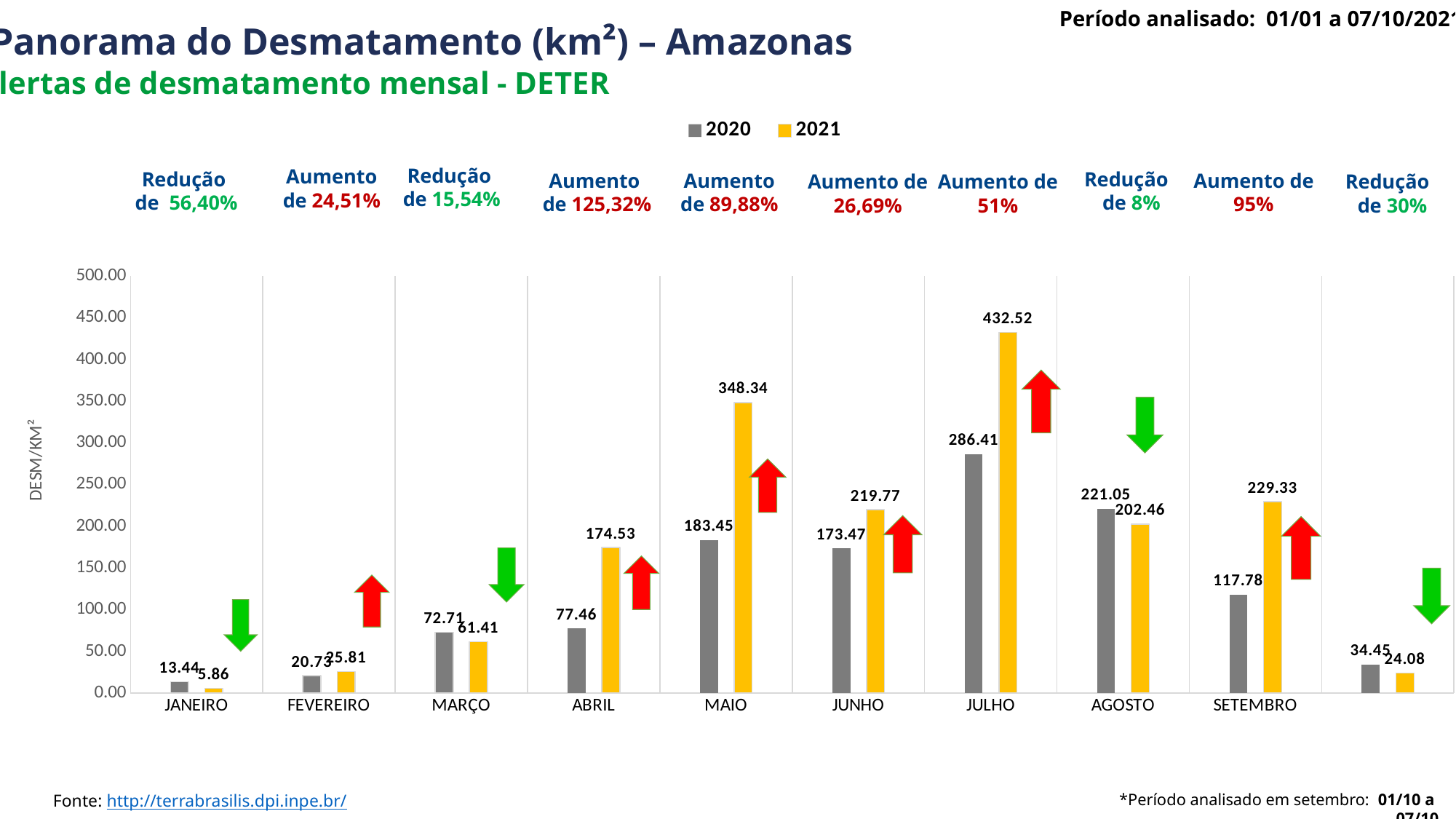
What is the difference between the 2021 and 2020 values in MAIO? 164.89 Which month has the highest value for the 2021 series? JULHO Which labeled month has the lowest value for the 2020 series? JANEIRO What kind of chart is shown on the slide? Bar chart What is the value for 2020 in MAIO? 183.45 What is the value for 2021 in JULHO? 432.52 What is the value for 2021 in SETEMBRO? 229.33 What is the value for 2020 in ABRIL? 77.46 How many series does the legend list? 2 In AGOSTO, which series has the larger value, 2020 or 2021? 2020 Which month has the highest value for the 2020 series? JULHO What is the difference between the 2021 and 2020 values in JULHO? 146.11